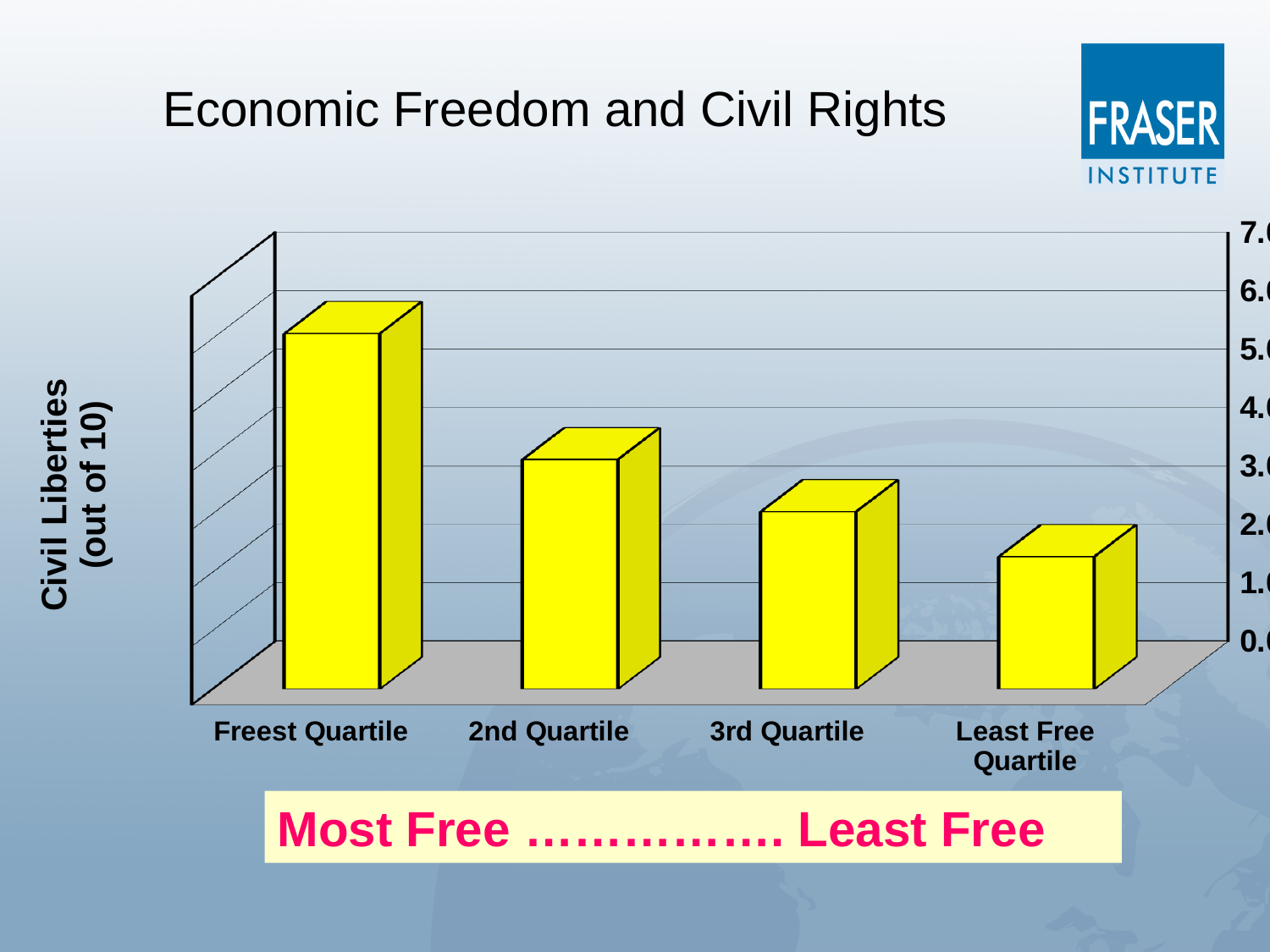
Which category has the highest civil liberties value? Freest Quartile What is the label on the vertical axis? Civil Liberties (out of 10) How many categories are plotted on the x axis? 4 Is the value for the 3rd Quartile greater or less than 4.0? less What is the title of the chart? Economic Freedom and Civil Rights Which category has the lowest civil liberties value? Least Free Quartile Is the value for the 2nd Quartile greater or less than 5.0? less What kind of chart is shown on the slide? bar chart Do the values rise or fall moving from the Freest Quartile to the Least Free Quartile? fall Is the value for the Freest Quartile greater or less than 4.0? greater Which is larger, the value for the 2nd Quartile or the 3rd Quartile? 2nd Quartile